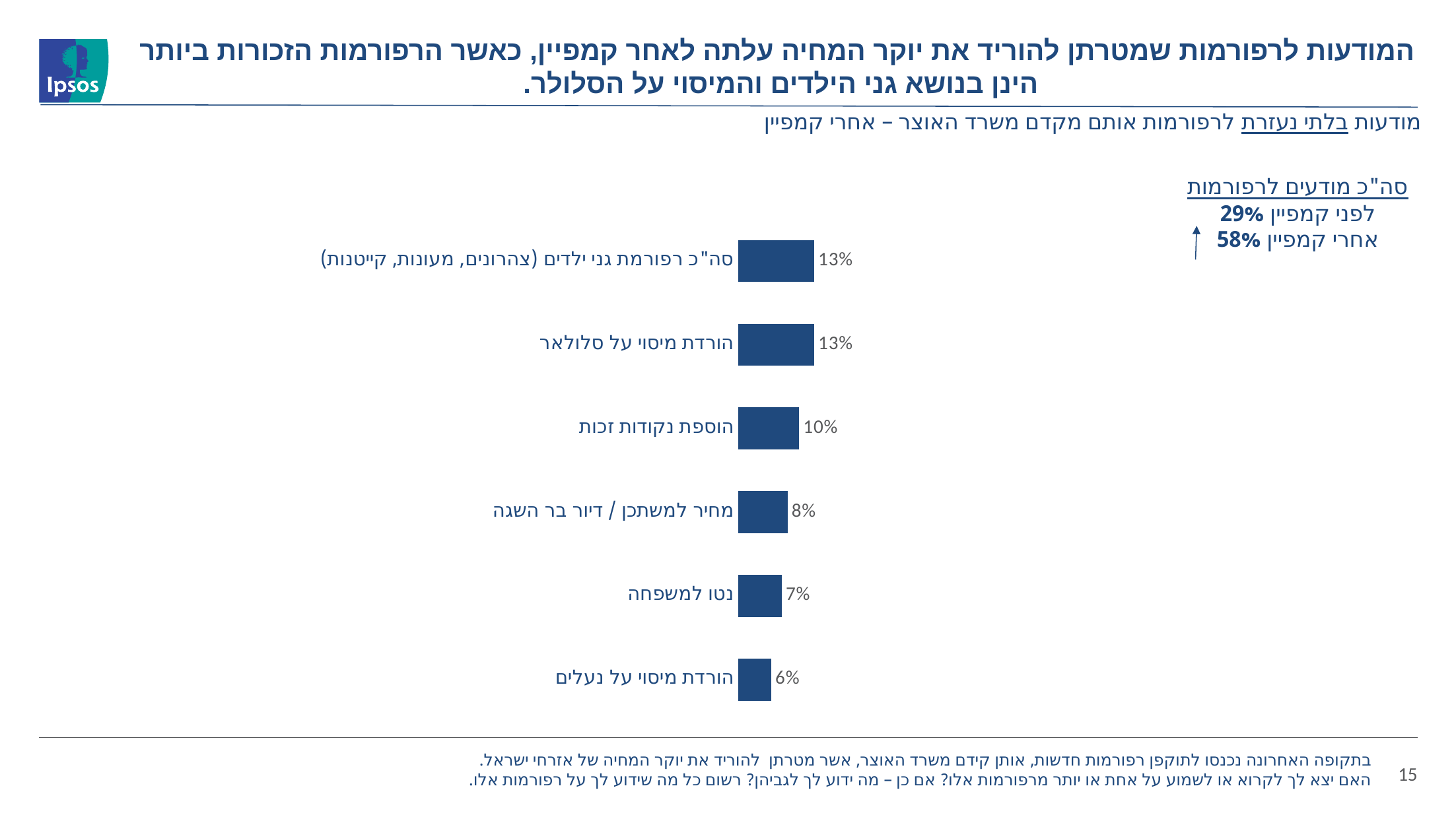
How many categories are shown in the chart? 6 What is the value for מחיר למשתכן / דיור בר השגה? 8% What is the value for הורדת מיסוי על סלולאר? 13% Which is larger, the value for מחיר למשתכן / דיור בר השגה or the value for הורדת מיסוי על נעלים? מחיר למשתכן / דיור בר השגה What is the difference between the values for הוספת נקודות זכות and נטו למשפחה? 3% Which category has the lowest value? הורדת מיסוי על נעלים What is the value for סה"כ רפורמת גני ילדים (צהרונים, מעונות, קייטנות)? 13% What is the value for נטו למשפחה? 7% What kind of chart is shown on the slide? Bar chart According to the text next to the chart, what was the total awareness of the reforms after the campaign (אחרי קמפיין)? 58% What is the value for הוספת נקודות זכות? 10% What is the difference between the values for הורדת מיסוי על סלולאר and הורדת מיסוי על נעלים? 7%